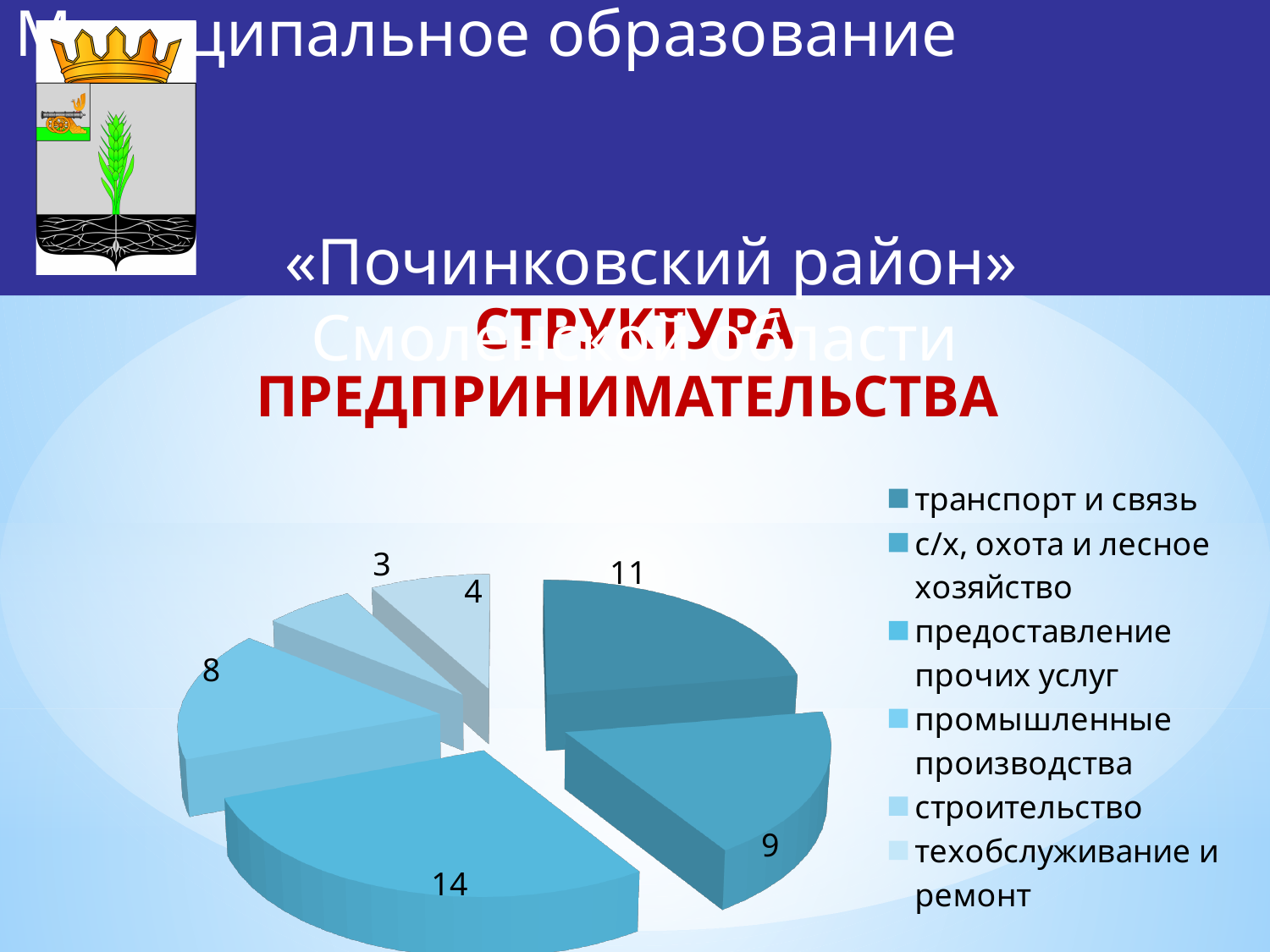
What is the total of all slices in the pie chart? 49 Which category has the smallest slice in the pie chart? строительство What is the value for «строительство» in the pie chart? 3 What is the value for «промышленные производства» in the pie chart? 8 Which category has the largest slice in the pie chart? предоставление прочих услуг What type of chart is shown on the slide? pie chart What is the difference between the values for «предоставление прочих услуг» and «транспорт и связь»? 3 How many slices does the pie chart have? 6 What is the value for «транспорт и связь» in the pie chart? 11 What is the value for «предоставление прочих услуг» in the pie chart? 14 Which is larger: «с/х, охота и лесное хозяйство» or «промышленные производства»? с/х, охота и лесное хозяйство What is the title of the chart on the slide? СТРУКТУРА ПРЕДПРИНИМАТЕЛЬСТВА